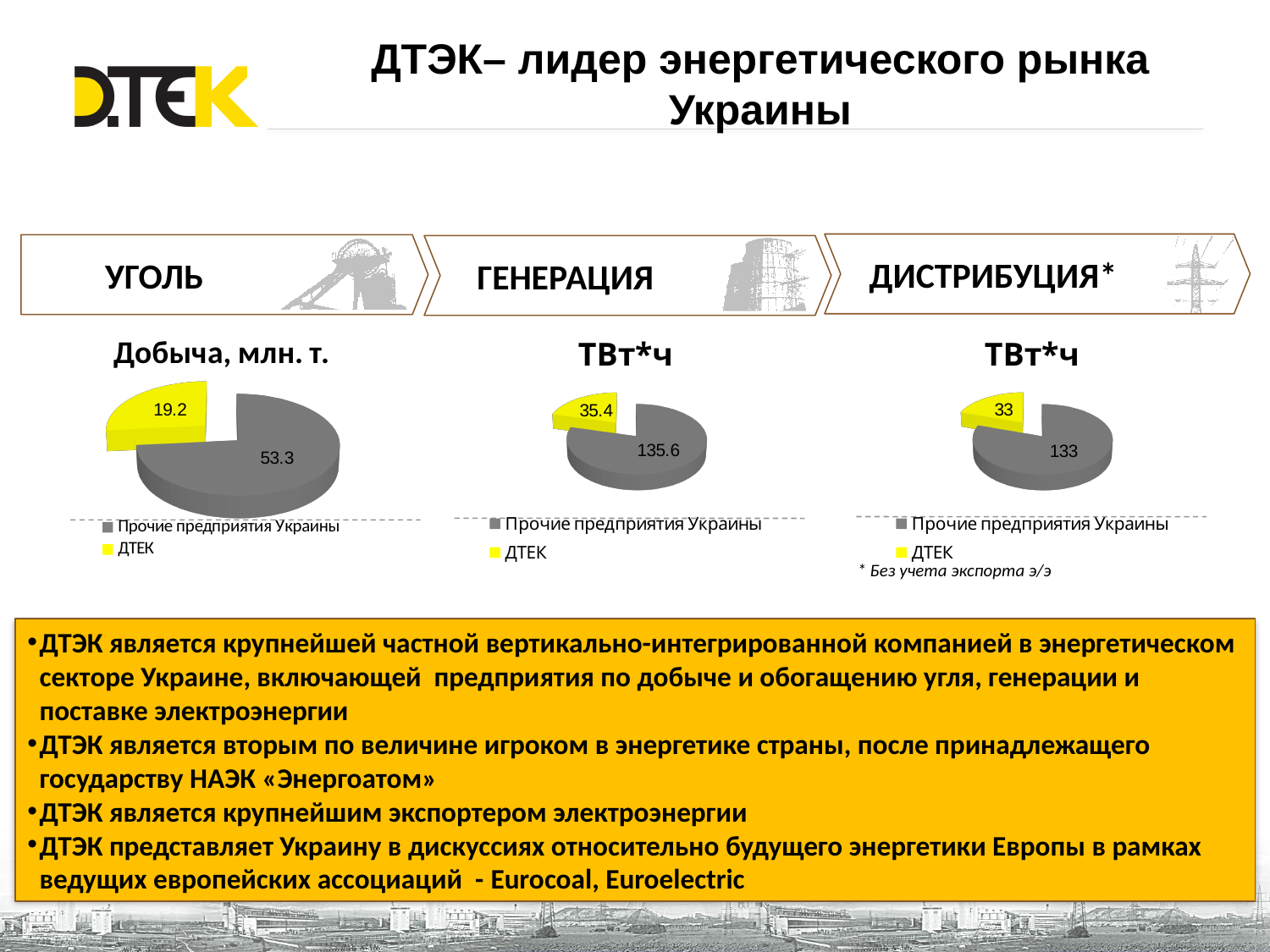
In the distribution (ДИСТРИБУЦИЯ*) pie chart, what is the value for Прочие предприятия Украины? 133 In the generation (ГЕНЕРАЦИЯ) pie chart, what is the value for ДТЕК? 35.4 In the distribution (ДИСТРИБУЦИЯ*) pie chart, what is the value for ДТЕК? 33 What type of chart is used for the coal (УГОЛЬ) data? Pie chart How many slices does the generation (ГЕНЕРАЦИЯ) pie chart have? 2 In the distribution (ДИСТРИБУЦИЯ*) pie chart, what is the total of the two slices? 166 In the generation (ГЕНЕРАЦИЯ) pie chart, which slice is larger: ДТЕК or Прочие предприятия Украины? Прочие предприятия Украины In the coal (УГОЛЬ) pie chart, what is the difference between the Прочие предприятия Украины value and the ДТЕК value? 34.1 What is the title shown above the coal (УГОЛЬ) pie chart? Добыча, млн. т. In the coal (УГОЛЬ) pie chart, what is the value for ДТЕК? 19.2 In the generation (ГЕНЕРАЦИЯ) pie chart, what is the value for Прочие предприятия Украины? 135.6 In the coal (УГОЛЬ) pie chart, what is the value for Прочие предприятия Украины? 53.3